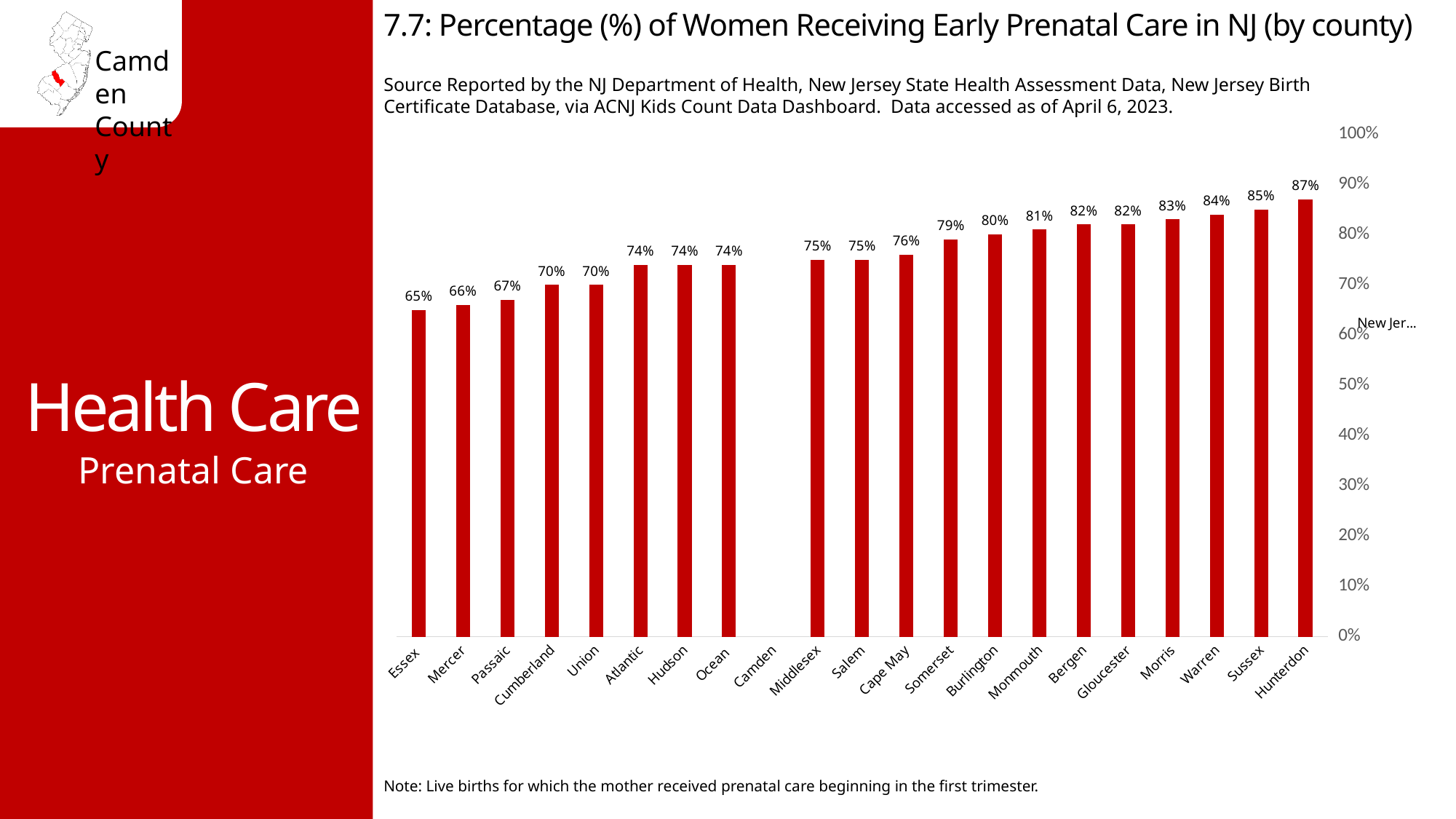
Is the value for Morris greater or less than 80%? greater Which county on the x axis has no bar or data label shown? Camden What is the value shown for Somerset County? 79% What is the difference between the values for Hunterdon and Essex? 22% What percentage of women received early prenatal care in Essex County? 65% How many counties are labeled on the x axis of the chart? 21 What is the value shown for Hunterdon County? 87% Which county has the lowest percentage of women receiving early prenatal care among those with a bar shown? Essex Which has a higher value, Bergen or Cape May? Bergen What kind of chart is shown on the slide? Bar chart Do the values generally rise or fall from left to right along the x axis? Rise Which county has the highest percentage of women receiving early prenatal care? Hunterdon